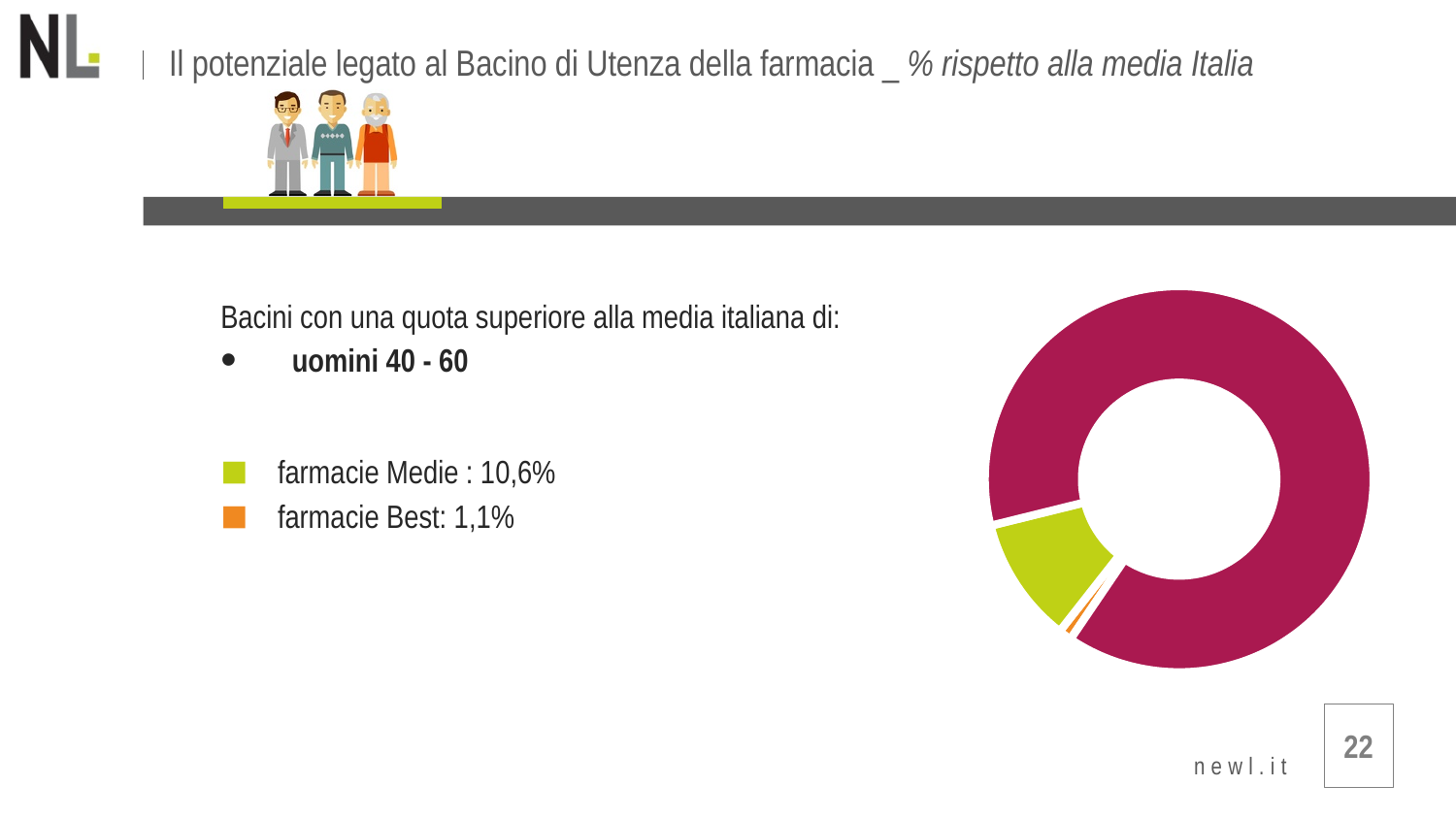
Of the two labelled categories, which has the smaller value? farmacie Best How many slices does the donut chart have? 3 How many entries does the legend list? 2 What colour represents farmacie Best in the chart? Orange What is the difference between the values for farmacie Medie and farmacie Best? 9,5% What colour represents farmacie Medie in the chart? Green What kind of chart is shown on the slide? Pie chart (donut) Which is larger, farmacie Medie or farmacie Best? farmacie Medie What is the value for farmacie Medie? 10,6% What is the value for farmacie Best? 1,1% Of the two labelled categories, which has the larger value? farmacie Medie